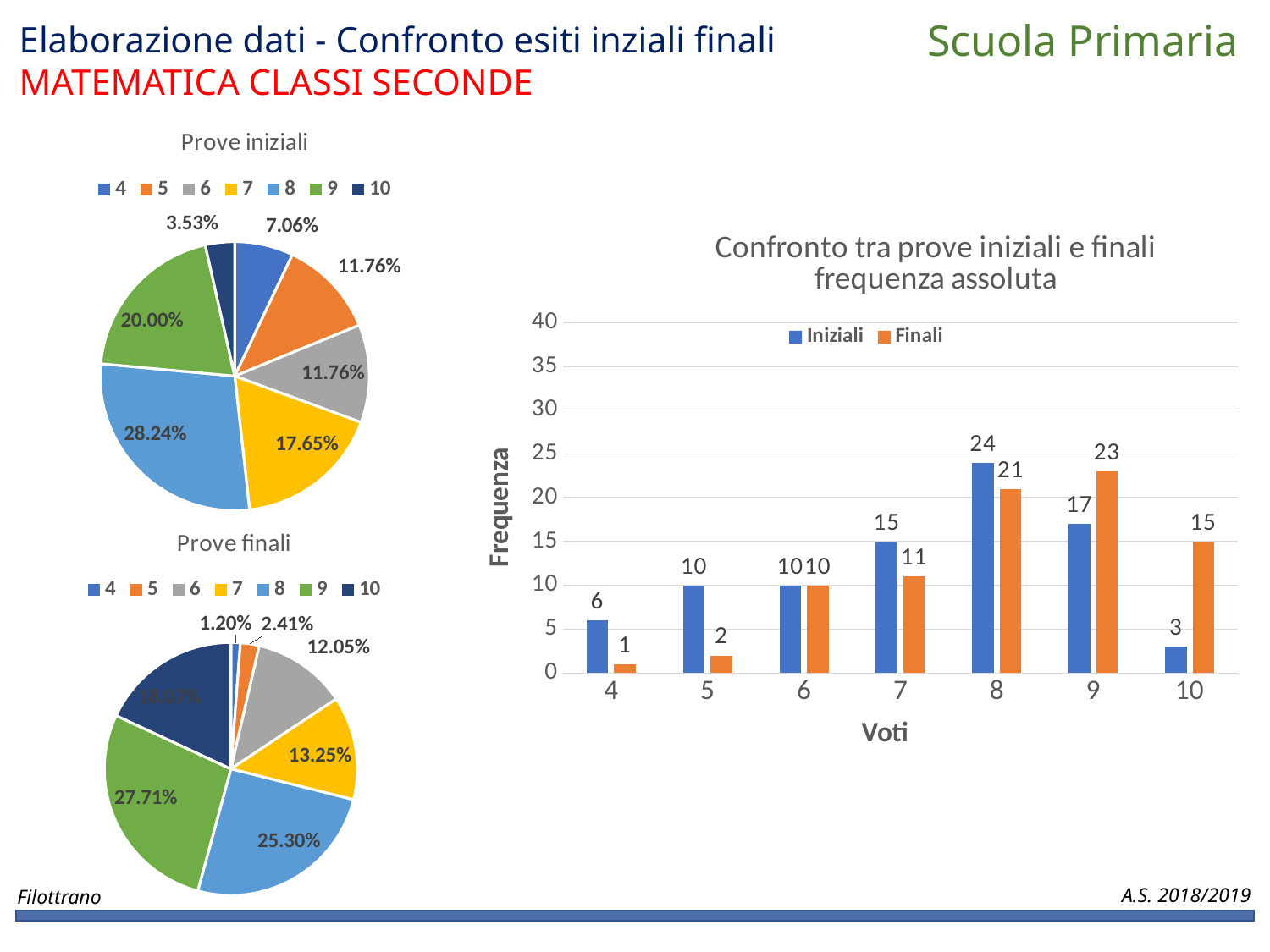
In the 'Confronto tra prove iniziali e finali frequenza assoluta' chart, which voto has the highest Finali value? 9 In the 'Confronto tra prove iniziali e finali frequenza assoluta' chart, which is larger for voto 7: Iniziali or Finali? Iniziali How many voti categories are shown on the x axis of the 'Confronto tra prove iniziali e finali frequenza assoluta' chart? 7 In the 'Confronto tra prove iniziali e finali frequenza assoluta' chart, which voto has the lowest Iniziali value? 10 In the 'Confronto tra prove iniziali e finali frequenza assoluta' chart, what is the Finali value for voto 10? 15 In the 'Confronto tra prove iniziali e finali frequenza assoluta' chart, what is the Iniziali value for voto 8? 24 What is the label on the y axis of the 'Confronto tra prove iniziali e finali frequenza assoluta' chart? Frequenza What kind of chart is 'Confronto tra prove iniziali e finali frequenza assoluta'? Bar chart In the 'Prove finali' pie chart, what share does voto 9 have? 27.71% In the 'Prove iniziali' pie chart, what share does voto 8 have? 28.24% How many series does the legend of the 'Confronto tra prove iniziali e finali frequenza assoluta' chart list? 2 In the 'Confronto tra prove iniziali e finali frequenza assoluta' chart, what is the difference between the Iniziali and Finali values for voto 10? 12